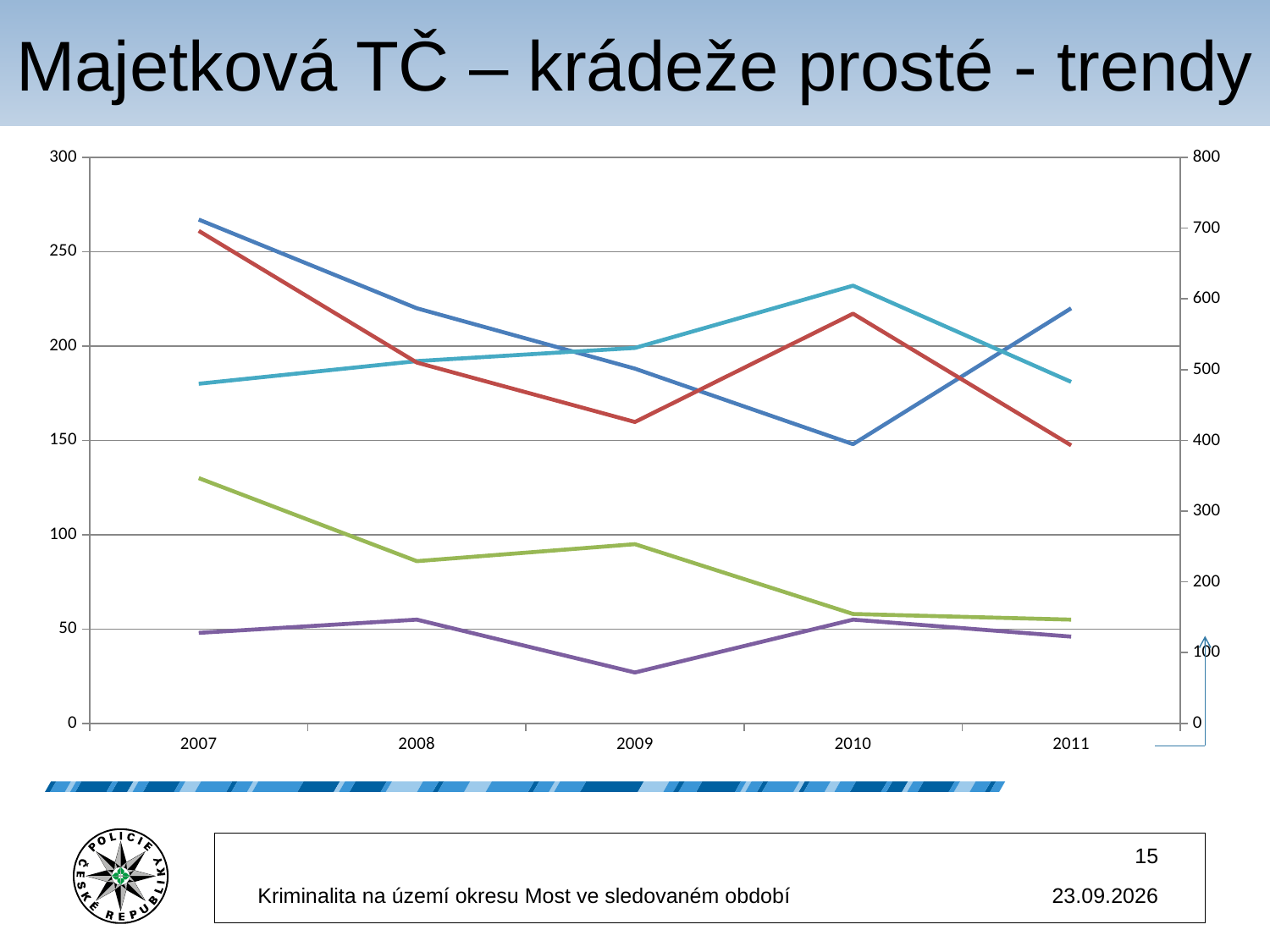
Does the green line rise or fall overall from 2007 to 2011? fall What is the first year shown on the x axis of the chart? 2007 In which year does the red line reach its highest point? 2007 How many years are shown along the x axis of the chart? 5 Does the red line rise or fall from 2007 to 2009? fall What kind of chart is shown on the slide? line chart Reading against the left axis, is the green line's value in 2007 greater or less than 100? greater What is the title of the slide containing the chart? Majetková TČ – krádeže prosté - trendy How many lines are plotted on the chart? 5 In which year does the light blue (cyan) line reach its highest point? 2010 In which year does the purple line reach its lowest point? 2009 Reading against the left axis, is the purple line's value in 2009 greater or less than 50? less